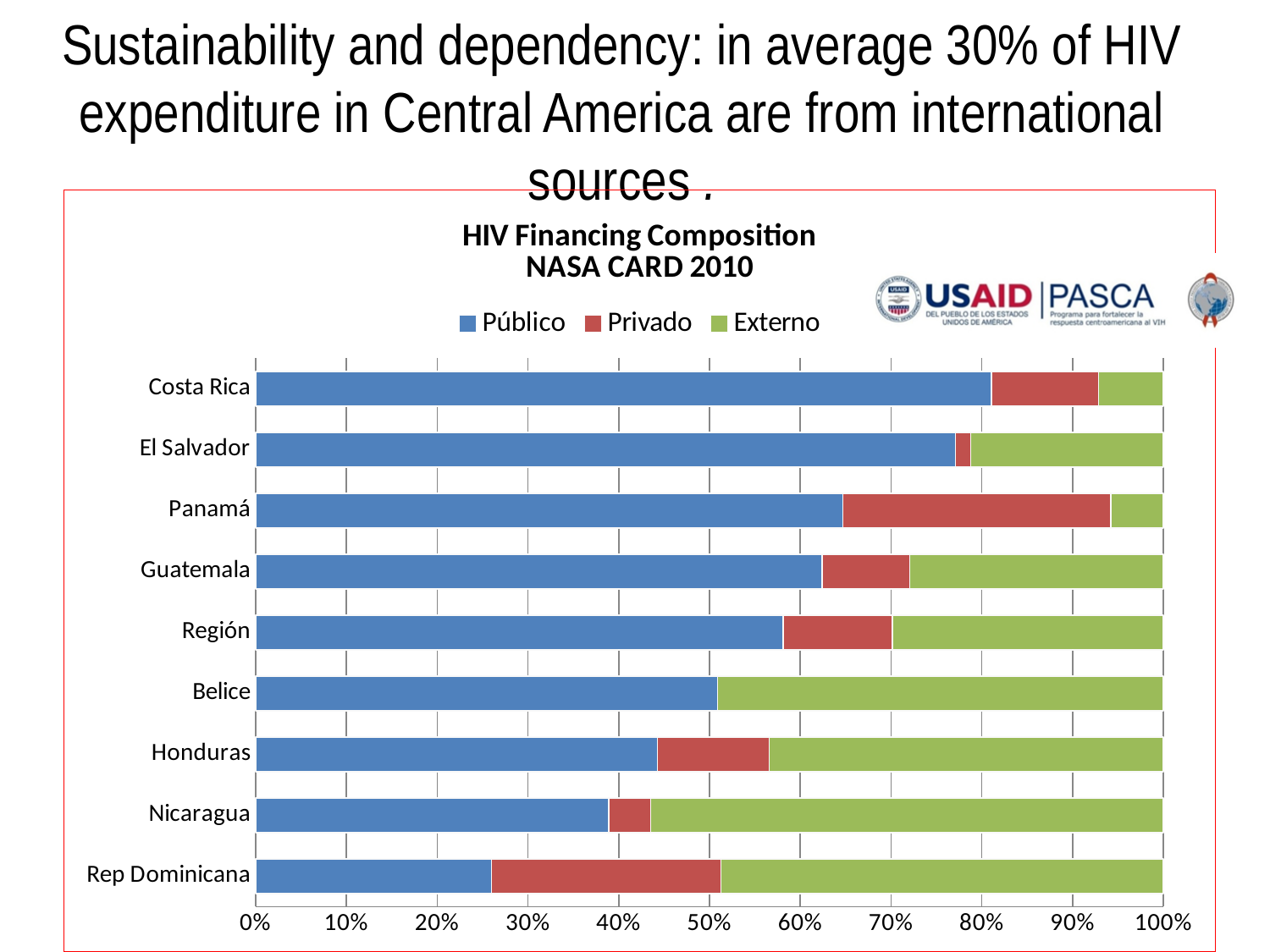
Is the Público share for Rep Dominicana greater or less than 30%? less Which category has the smallest Público share? Rep Dominicana Is the Público share for Panamá greater or less than 60%? greater Which category has the largest Público share? Costa Rica What kind of chart is shown on the slide? bar chart Is the Público share for El Salvador greater or less than 70%? greater Which colour represents the Externo series in the chart? green How many series does the chart legend list? 3 What is the title of the chart? HIV Financing Composition NASA CARD 2010 How many countries/regions are listed on the vertical axis of the chart? 9 Which has a larger Público share, Panamá or Honduras? Panamá